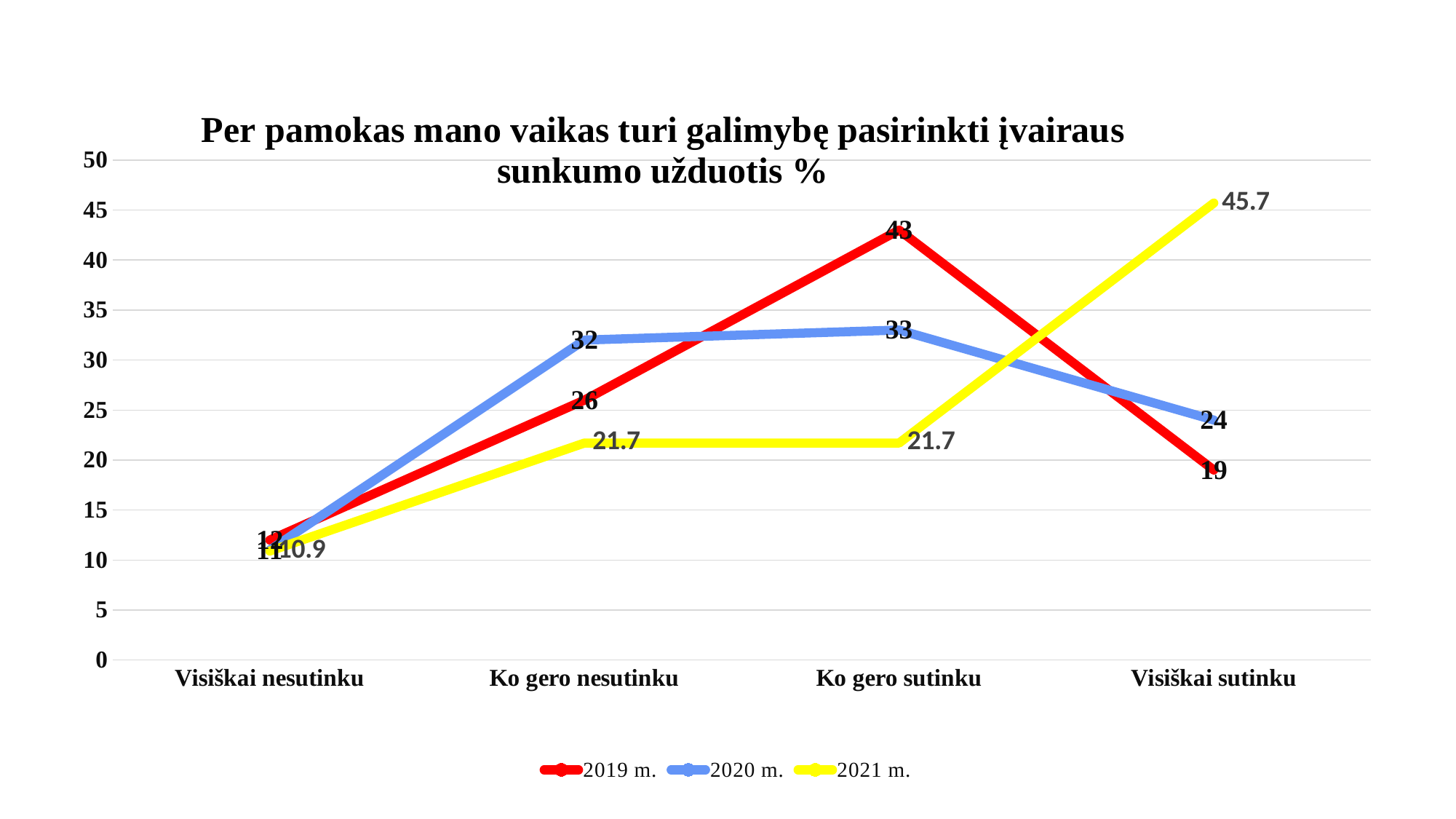
How many series does the legend list? 3 What type of chart is shown on the slide? line chart At Ko gero sutinku, which series has the larger value, 2020 m. or 2021 m.? 2020 m. Which category has the lowest value for the 2021 m. series? Visiškai nesutinku What is the value for 2021 m. at Ko gero nesutinku? 21.7 What is the value for 2021 m. at Visiškai sutinku? 45.7 What is the value for 2020 m. at Ko gero nesutinku? 32 What is the difference between the 2019 m. and 2020 m. values at Visiškai sutinku? 5 Which colour is used for the 2021 m. series? yellow How many categories are shown on the x axis? 4 What is the value for 2019 m. at Ko gero sutinku? 43 Which category has the highest value for the 2019 m. series? Ko gero sutinku